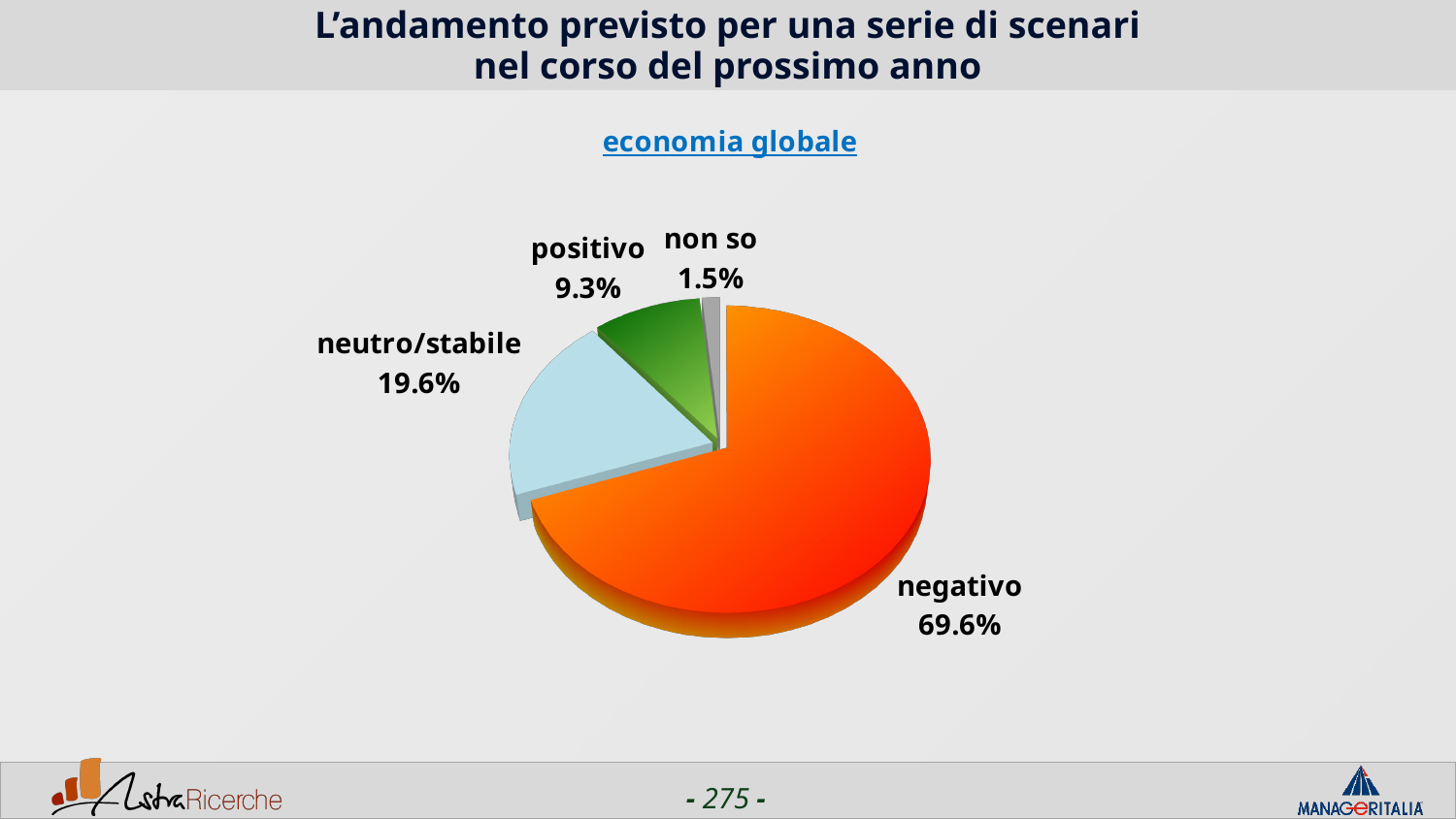
How many categories are shown in the pie chart? 4 What is the value for 'neutro/stabile'? 19.6% What kind of chart is shown on the slide? pie chart What is the difference between the values for 'positivo' and 'non so'? 7.8% What is the subtitle shown above the pie chart? economia globale What is the value for 'negativo'? 69.6% Which category has the smallest share of the pie? non so What is the value for 'positivo'? 9.3% Which is larger, the value for 'positivo' or the value for 'neutro/stabile'? neutro/stabile What is the difference between the values for 'negativo' and 'neutro/stabile'? 50.0% What is the value for 'non so'? 1.5% Which category has the largest share of the pie? negativo